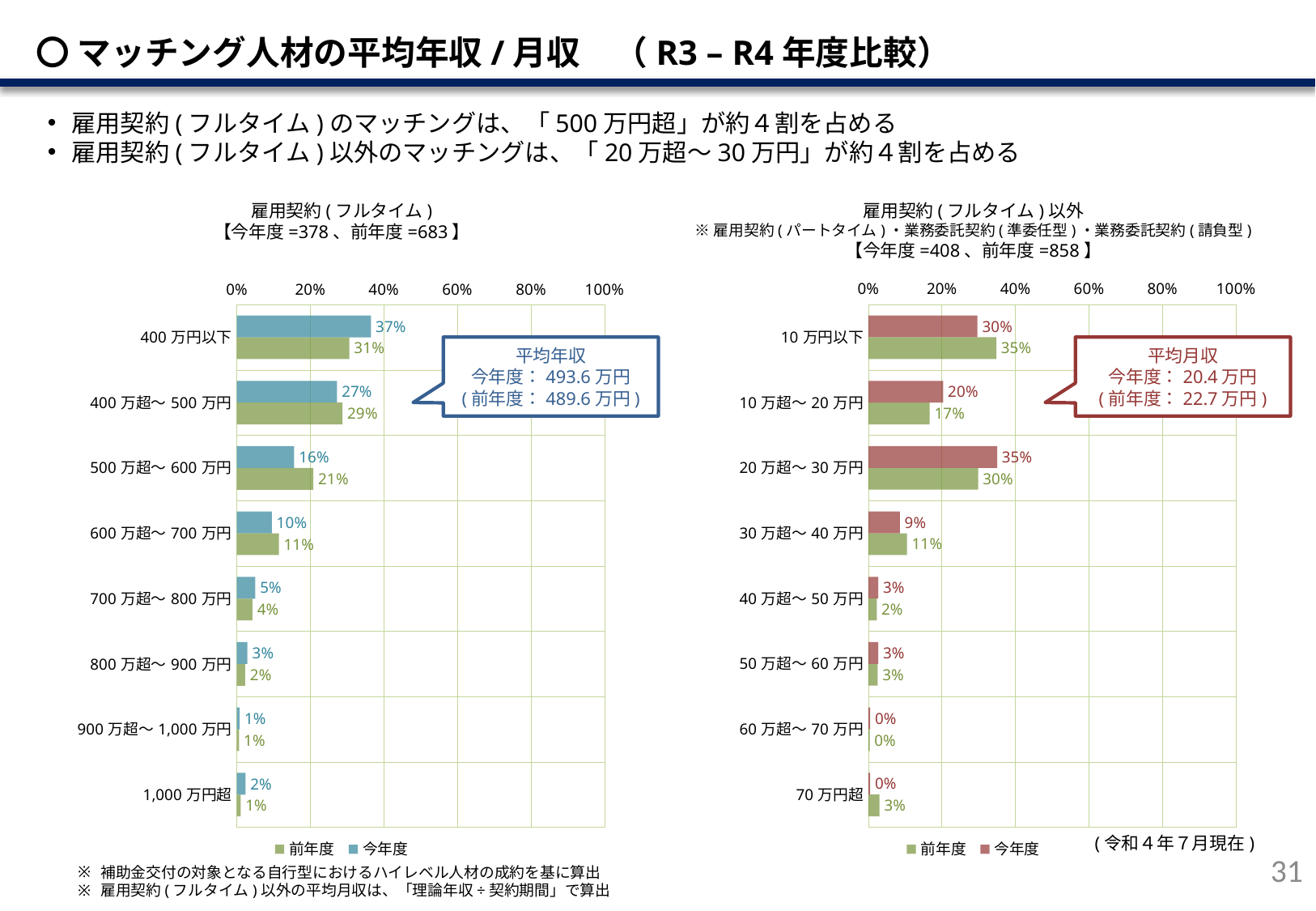
In the left chart (雇用契約(フルタイム)), how many income categories are shown? 8 In the left chart (雇用契約(フルタイム)), what kind of chart is it? Bar chart In the right chart (雇用契約(フルタイム)以外), how many series does the legend list? 2 In the left chart (雇用契約(フルタイム)), what is the difference between the 今年度 and 前年度 values for 400万円以下? 6% In the right chart (雇用契約(フルタイム)以外), what is the difference between the 前年度 and 今年度 values for 70万円超? 3% In the left chart (雇用契約(フルタイム)), what is the 今年度 value for 400万円以下? 37% In the right chart (雇用契約(フルタイム)以外), what is the 今年度 value for 20万超〜30万円? 35% In the right chart (雇用契約(フルタイム)以外), what is the 前年度 value for 10万円以下? 35% In the right chart (雇用契約(フルタイム)以外), which category has the highest 今年度 value? 20万超〜30万円 In the left chart (雇用契約(フルタイム)), what is the 前年度 value for 500万超〜600万円? 21% In the right chart (雇用契約(フルタイム)以外), which is larger for 10万超〜20万円: the 今年度 value or the 前年度 value? 今年度 In the left chart (雇用契約(フルタイム)), which category has the highest 今年度 value? 400万円以下